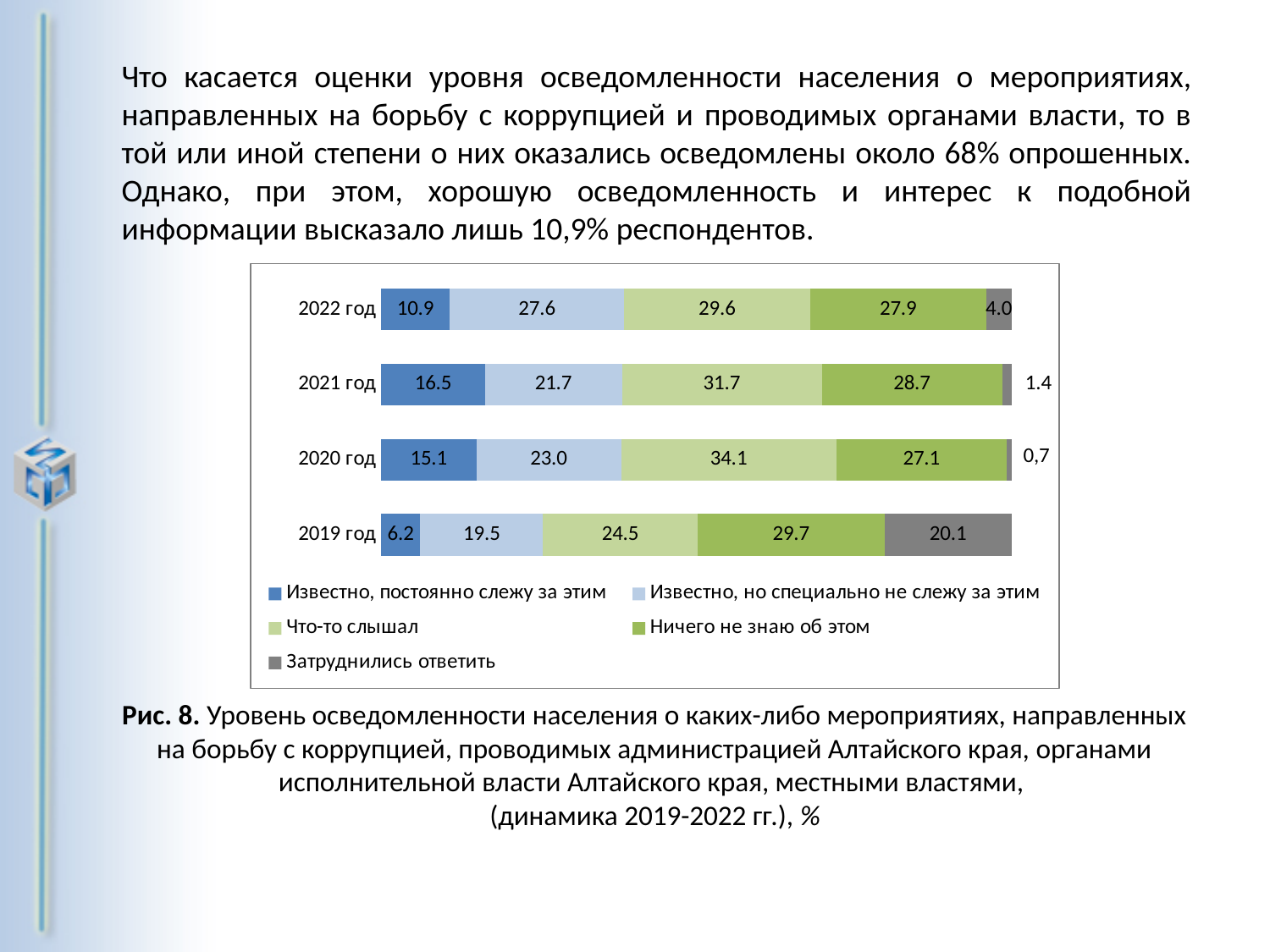
What is the value for "Что-то слышал" in 2020 год? 34.1 Which year has the highest value for "Известно, постоянно слежу за этим"? 2021 год What is the difference between the "Известно, постоянно слежу за этим" values for 2021 год and 2022 год? 5.6 What is the value for "Затруднились ответить" in 2019 год? 20.1 What is the value for "Ничего не знаю об этом" in 2021 год? 28.7 How many series does the legend list? 5 Which year has the lowest value for "Затруднились ответить"? 2020 год What is the total of the stacked bar for 2019 год? 100.0 What kind of chart is shown on the slide? Stacked bar chart What is the value for "Известно, постоянно слежу за этим" in 2022 год? 10.9 How many years (categories) are shown in the chart? 4 Which is larger: the "Известно, но специально не слежу за этим" value for 2022 год or for 2020 год? 2022 год